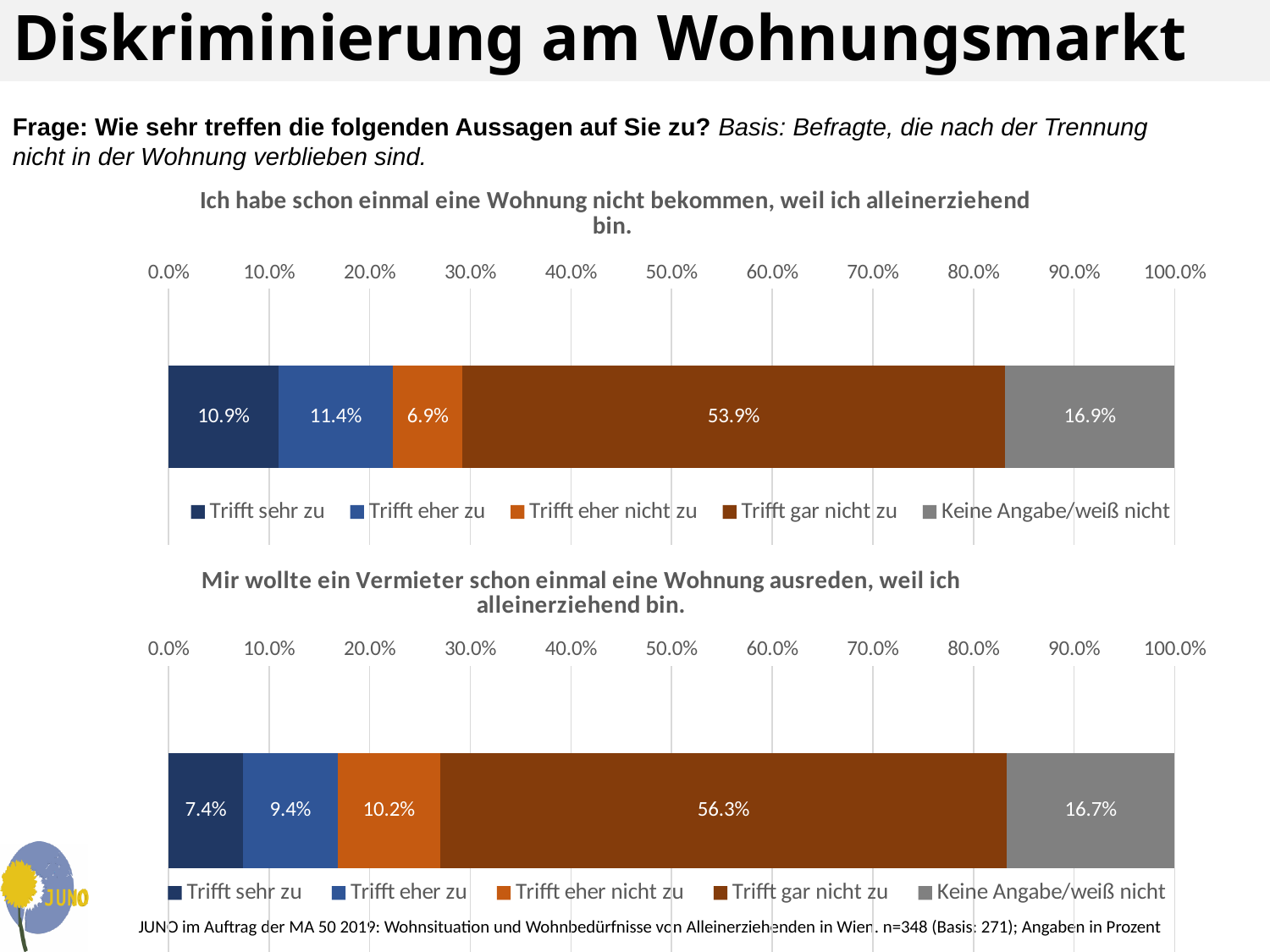
In the bottom chart ("Mir wollte ein Vermieter schon einmal eine Wohnung ausreden..."), what is the value for "Keine Angabe/weiß nicht"? 16.7% In the top chart ("Ich habe schon einmal eine Wohnung nicht bekommen..."), what is the value for "Trifft gar nicht zu"? 53.9% In the top chart ("Ich habe schon einmal eine Wohnung nicht bekommen..."), what is the combined share of "Trifft sehr zu" and "Trifft eher zu"? 22.3% In the bottom chart ("Mir wollte ein Vermieter schon einmal eine Wohnung ausreden..."), what is the value for "Trifft eher nicht zu"? 10.2% In the bottom chart ("Mir wollte ein Vermieter schon einmal eine Wohnung ausreden..."), which series has the smallest share? Trifft sehr zu How many series does the legend of the bottom chart ("Mir wollte ein Vermieter schon einmal eine Wohnung ausreden...") list? 5 What kind of chart is the top chart ("Ich habe schon einmal eine Wohnung nicht bekommen...")? Stacked bar chart In the top chart ("Ich habe schon einmal eine Wohnung nicht bekommen..."), which series has the largest share? Trifft gar nicht zu In the top chart ("Ich habe schon einmal eine Wohnung nicht bekommen..."), what is the value for "Trifft sehr zu"? 10.9% In the top chart ("Ich habe schon einmal eine Wohnung nicht bekommen..."), which is larger: "Trifft sehr zu" or "Trifft eher zu"? Trifft eher zu In the top chart ("Ich habe schon einmal eine Wohnung nicht bekommen..."), which series has the smallest share? Trifft eher nicht zu In the bottom chart ("Mir wollte ein Vermieter schon einmal eine Wohnung ausreden..."), what is the difference between "Trifft gar nicht zu" and "Keine Angabe/weiß nicht"? 39.6%